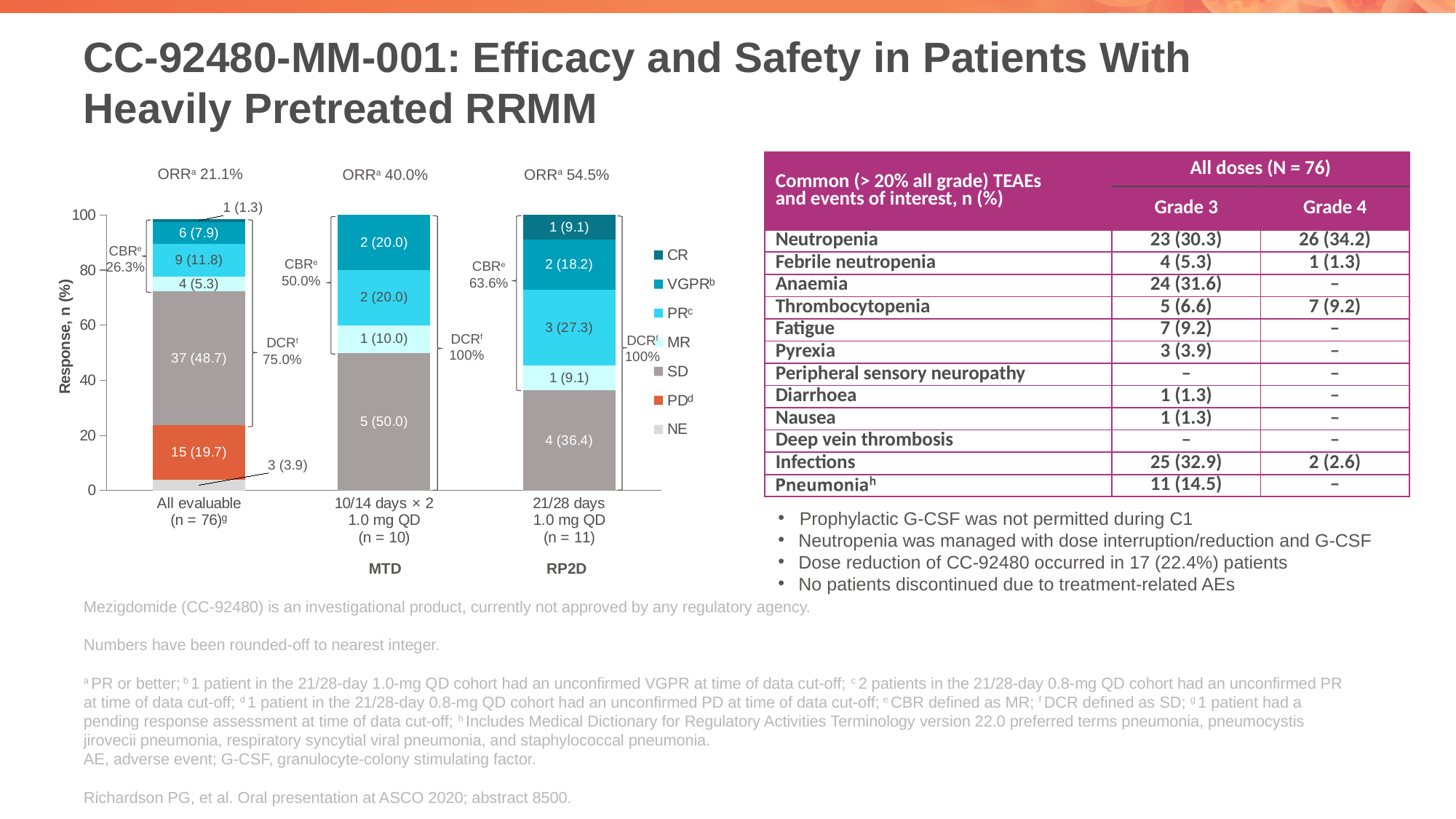
In the stacked bar chart, what is the value shown for SD in the 10/14 days × 2 1.0 mg QD (n = 10) bar? 5 (50.0) Which cohort has more PR patients: 10/14 days × 2 1.0 mg QD or 21/28 days 1.0 mg QD? 21/28 days 1.0 mg QD How many response categories does the chart legend list? 7 In the stacked bar chart, what is the value shown for CR in the 21/28 days 1.0 mg QD (n = 11) bar? 1 (9.1) What type of chart is used to show the response data? Stacked bar chart What ORR is shown above the 21/28 days 1.0 mg QD (n = 11) bar? 54.5% What DCR is shown for the All evaluable (n = 76) bar? 75.0% In the stacked bar chart, what is the value shown for SD in the All evaluable (n = 76) bar? 37 (48.7) In the stacked bar chart, what is the value shown for PD in the All evaluable (n = 76) bar? 15 (19.7) How many bars (cohorts) are shown in the stacked bar chart? 3 In the stacked bar chart, what is the value shown for VGPR in the 10/14 days × 2 1.0 mg QD (n = 10) bar? 2 (20.0) Which cohort has the highest ORR shown above its bar? 21/28 days 1.0 mg QD (n = 11)